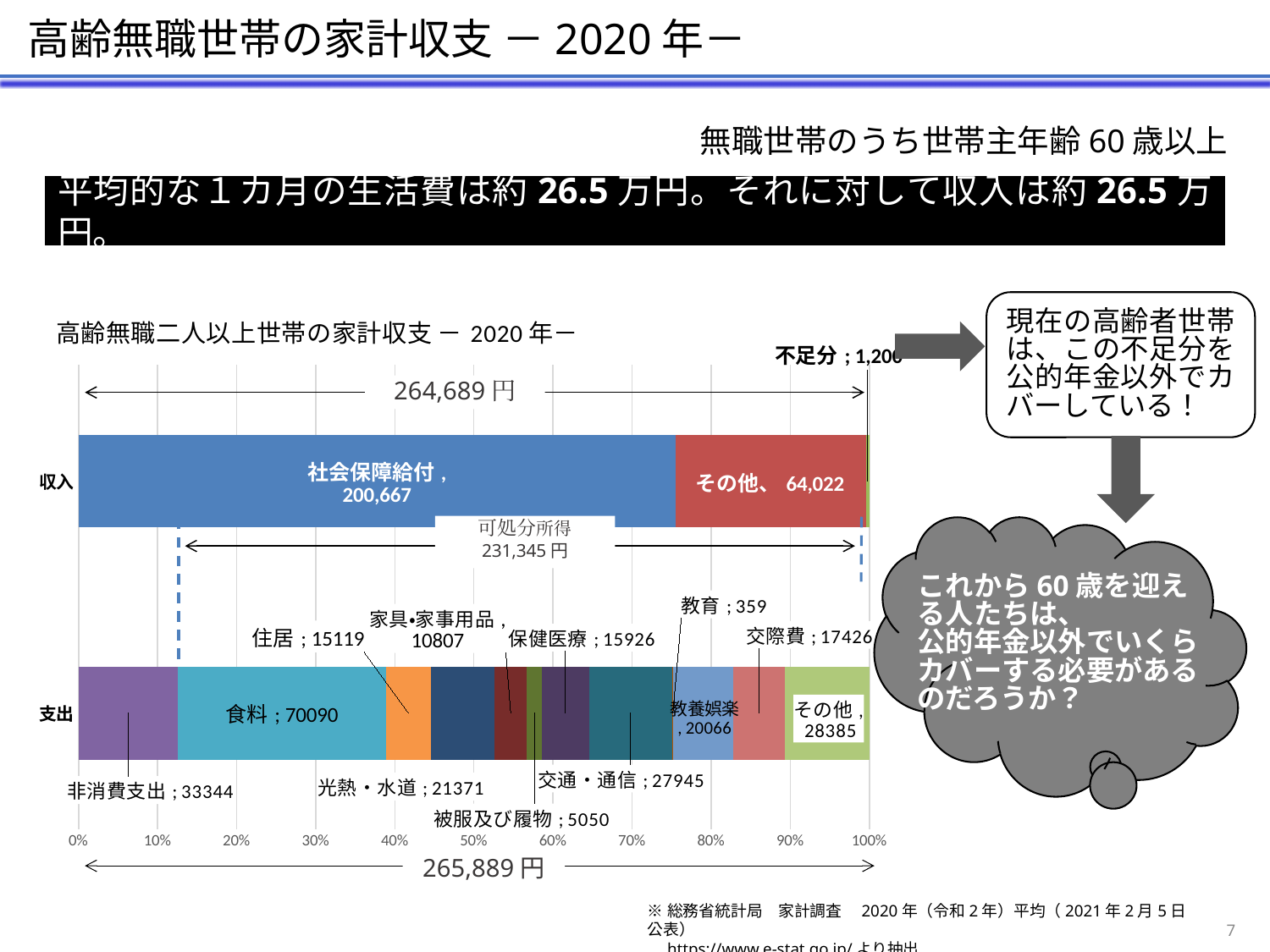
In the 支出 bar, what is the value for 食料? 70090 What kind of chart is shown on the slide? Stacked bar chart What is the value labelled 不足分 at the end of the 収入 bar? 1,200 Which category in the 支出 bar has the largest value? 食料 What is the 可処分所得 value shown on the chart? 231,345円 Which category in the 支出 bar has the smallest value? 教育 How many categories make up the 支出 bar? 12 In the 収入 bar, what is the value for 社会保障給付? 200,667 In the 支出 bar, what is the value for 教育? 359 In the 支出 bar, which is larger: 交通・通信 or 光熱・水道? 交通・通信 What is the total of the 支出 bar as printed on the slide? 265,889円 In the 収入 bar, what is the difference between 社会保障給付 and その他? 136,645